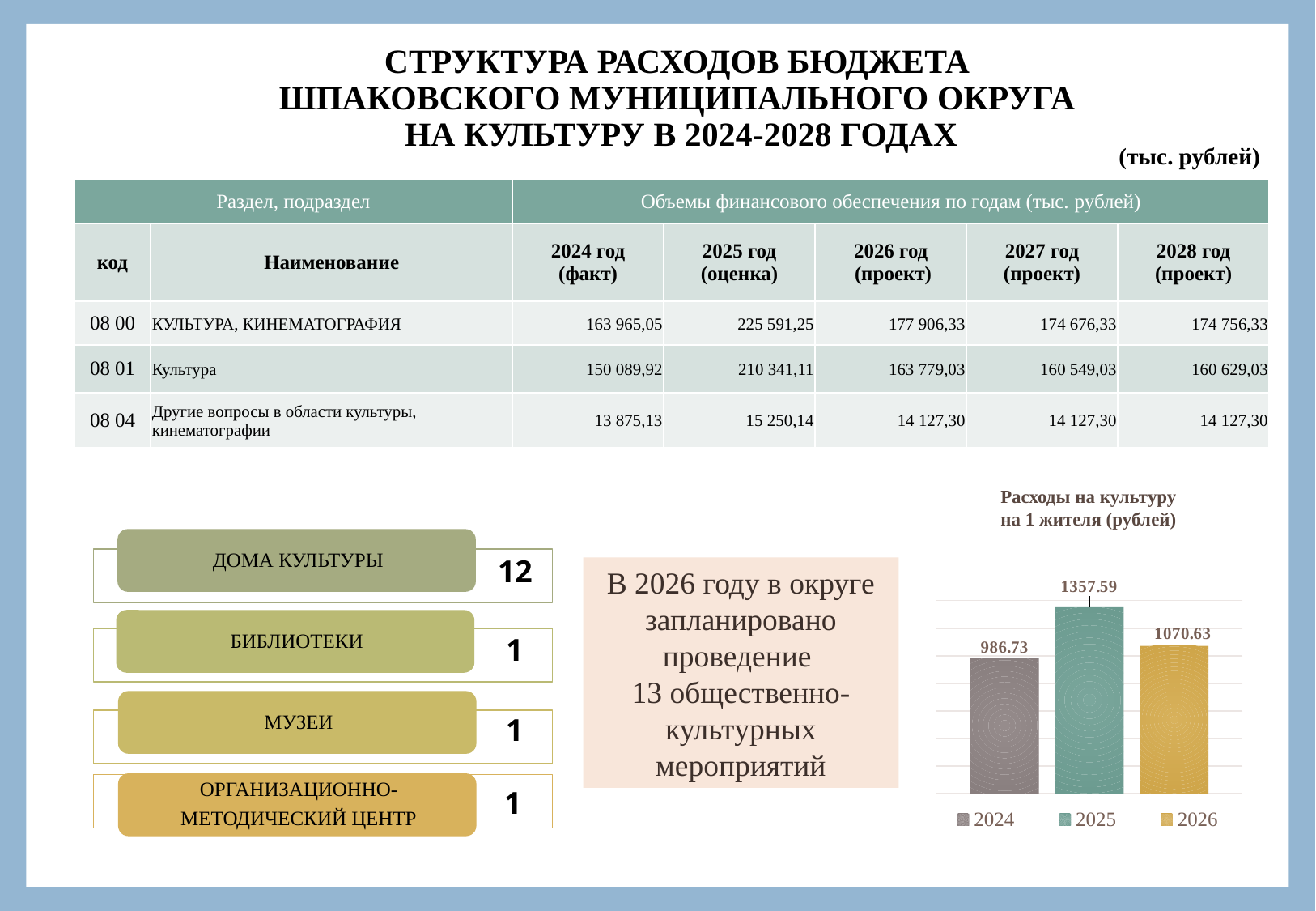
Which year has the highest value in the chart 'Расходы на культуру на 1 жителя (рублей)'? 2025 In the chart 'Расходы на культуру на 1 жителя (рублей)', what is the difference between the 2025 and 2026 values? 286.96 What is the value for 2024 in the chart 'Расходы на культуру на 1 жителя (рублей)'? 986.73 In the chart 'Расходы на культуру на 1 жителя (рублей)', does the value rise or fall from 2025 to 2026? fall In the chart 'Расходы на культуру на 1 жителя (рублей)', what is the difference between the 2025 and 2024 values? 370.86 How many entries does the legend of the chart 'Расходы на культуру на 1 жителя (рублей)' list? 3 How many bars are plotted in the chart 'Расходы на культуру на 1 жителя (рублей)'? 3 Which year has the lowest value in the chart 'Расходы на культуру на 1 жителя (рублей)'? 2024 What kind of chart is 'Расходы на культуру на 1 жителя (рублей)'? bar chart What is the value for 2025 in the chart 'Расходы на культуру на 1 жителя (рублей)'? 1357.59 What is the value for 2026 in the chart 'Расходы на культуру на 1 жителя (рублей)'? 1070.63 In the chart 'Расходы на культуру на 1 жителя (рублей)', which is larger: the value for 2026 or the value for 2024? 2026